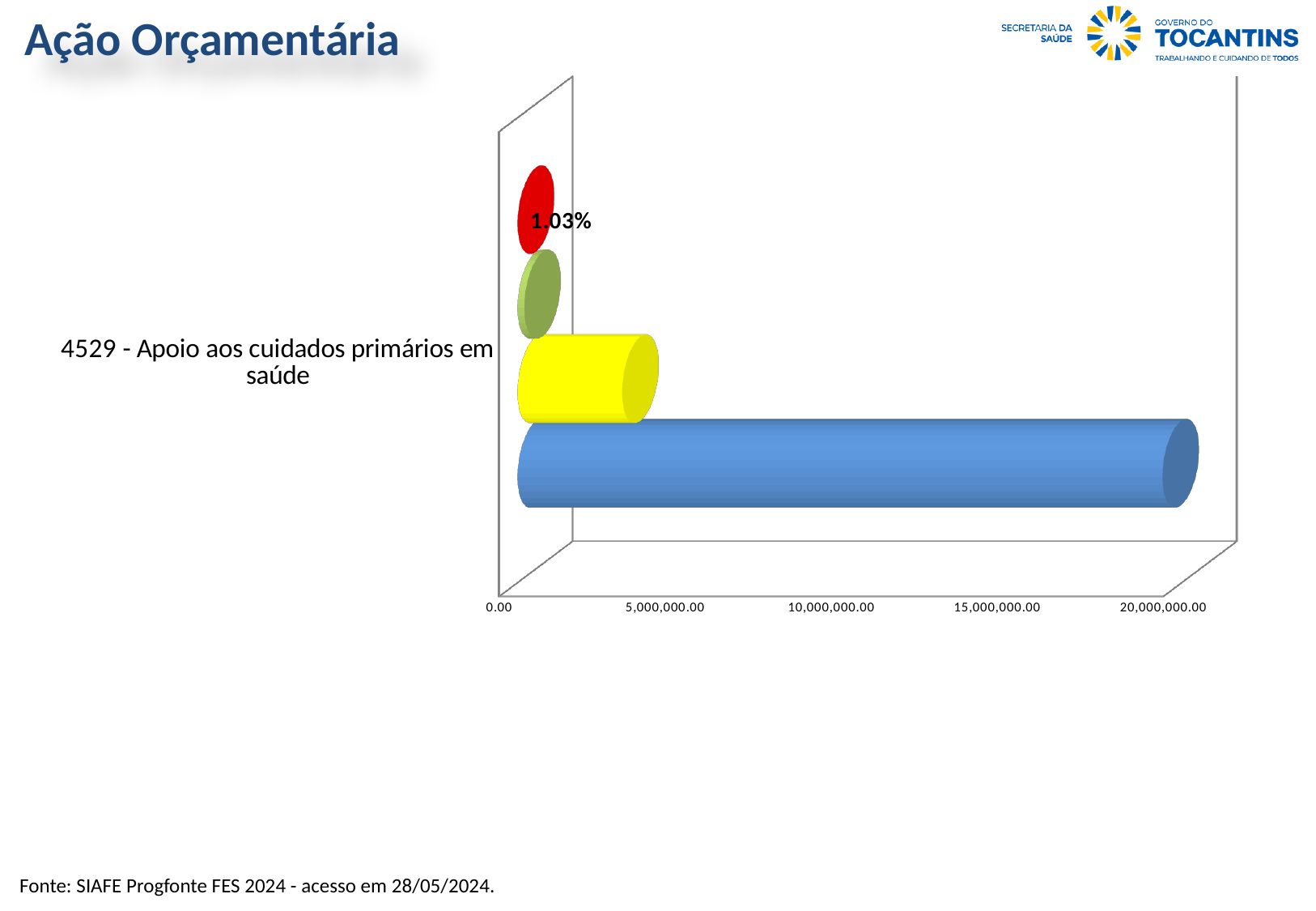
What is the highest tick value shown on the horizontal axis? 20,000,000.00 Is the value of the green bar greater or less than 5,000,000.00? less Which bar is longer, the blue bar or the yellow bar? blue What kind of chart is shown on the slide? bar chart Which coloured bar is the longest in the chart? blue Is the value of the blue bar greater or less than 15,000,000.00? greater What percentage label is printed next to the red bar? 1.03% How many categories are shown on the vertical axis of the chart? 1 Which bar is longer, the yellow bar or the green bar? yellow Is the value of the yellow bar greater or less than 5,000,000.00? less What is the category label shown on the chart's vertical axis? 4529 - Apoio aos cuidados primários em saúde How many bars are plotted for the category "4529 - Apoio aos cuidados primários em saúde"? 4